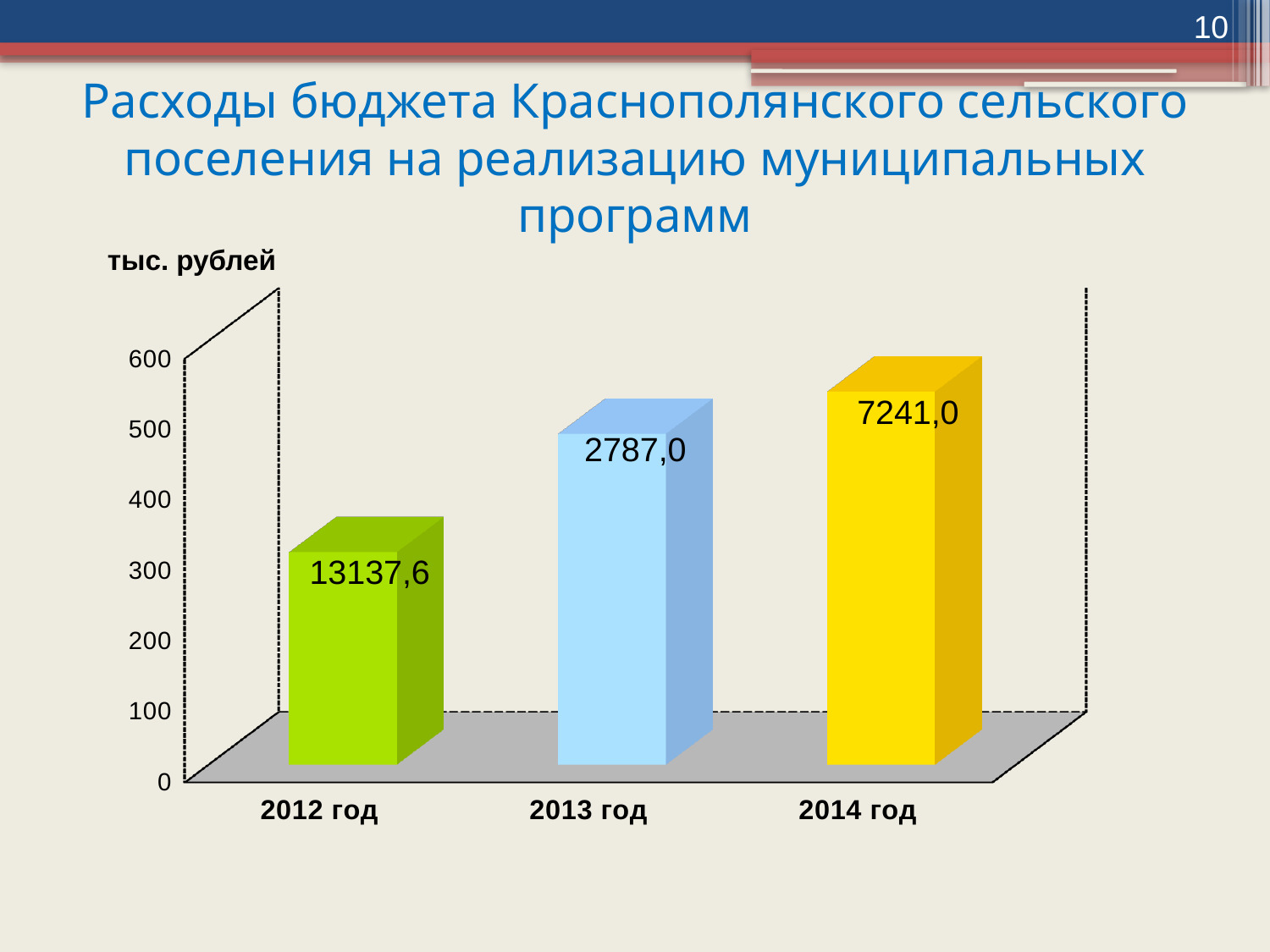
What kind of chart is shown on the slide? Bar chart What is the value for 2014 год? 7241,0 How many years (categories) are shown on the chart? 3 What is the value for 2013 год? 2787,0 What is the value for 2012 год? 13137,6 What unit is indicated above the vertical axis of the chart? тыс. рублей What colour is the bar for 2014 год? Yellow What is the difference between the labelled values for 2012 год and 2014 год? 5896,6 What is the difference between the labelled values for 2014 год and 2013 год? 4454,0